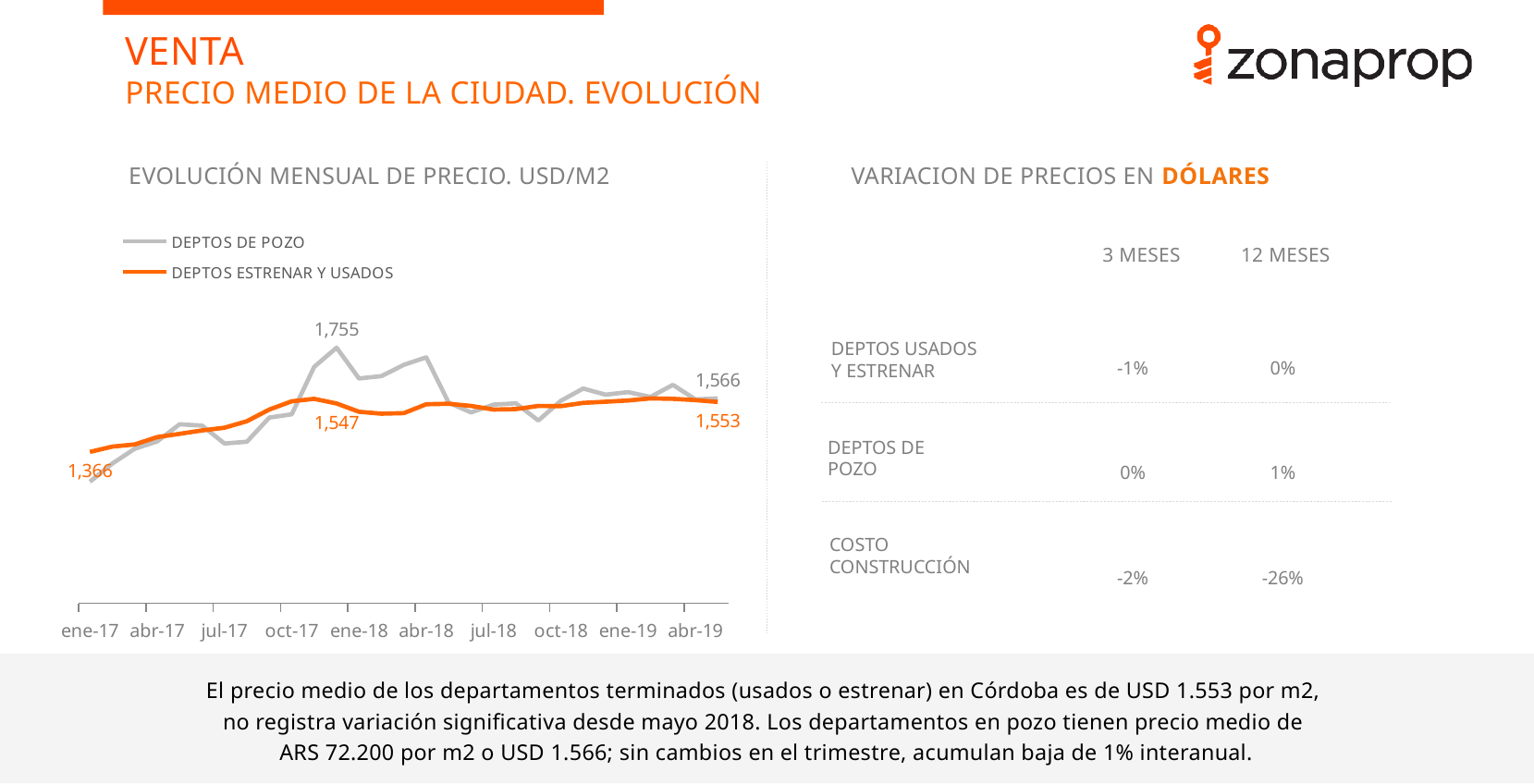
How much lower is the final DEPTOS DE POZO value (1,566) than its labelled peak (1,755)? 189 What kind of chart is shown under 'EVOLUCIÓN MENSUAL DE PRECIO. USD/M2'? Line chart How many series does the legend of the line chart list? 2 What are the two series named in the legend of the line chart? DEPTOS DE POZO and DEPTOS ESTRENAR Y USADOS What is the labelled peak value of the DEPTOS DE POZO line? 1,755 At abr-19, which series has the higher labelled value, DEPTOS DE POZO or DEPTOS ESTRENAR Y USADOS? DEPTOS DE POZO What is the labelled value of DEPTOS ESTRENAR Y USADOS at the start of the line chart (ene-17)? 1,366 What is the labelled value of DEPTOS DE POZO at the end of the line chart (abr-19)? 1,566 What is the difference between the final labelled values of DEPTOS DE POZO (1,566) and DEPTOS ESTRENAR Y USADOS (1,553)? 13 Does the DEPTOS ESTRENAR Y USADOS line rise or fall overall from ene-17 to abr-19? Rise What is the labelled value of DEPTOS ESTRENAR Y USADOS at the end of the line chart (abr-19)? 1,553 How many date labels are shown on the x axis of the line chart? 10